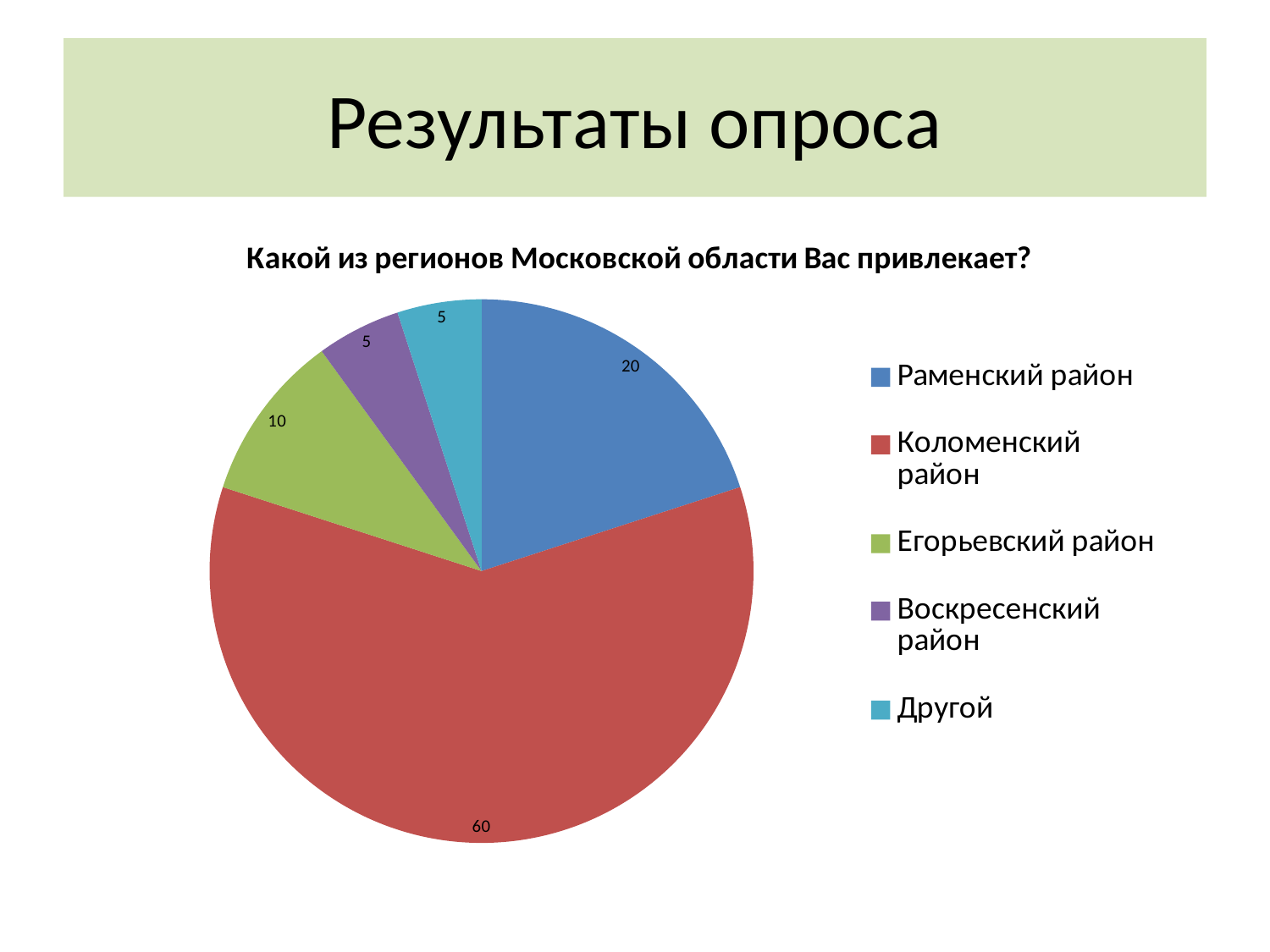
What share of the pie does Коломенский район represent? 60% Which category has the largest slice of the pie? Коломенский район What is the value for Коломенский район? 60 Which is larger, the value for Раменский район or the value for Егорьевский район? Раменский район What is the difference between the values for Коломенский район and Раменский район? 40 What is the value for Егорьевский район? 10 What is the value for Другой? 5 What kind of chart is shown on the slide? pie chart What share of the pie does Раменский район represent? 20% What is the title of the chart? Какой из регионов Московской области Вас привлекает? What is the value for Раменский район? 20 How many categories does the pie chart have? 5